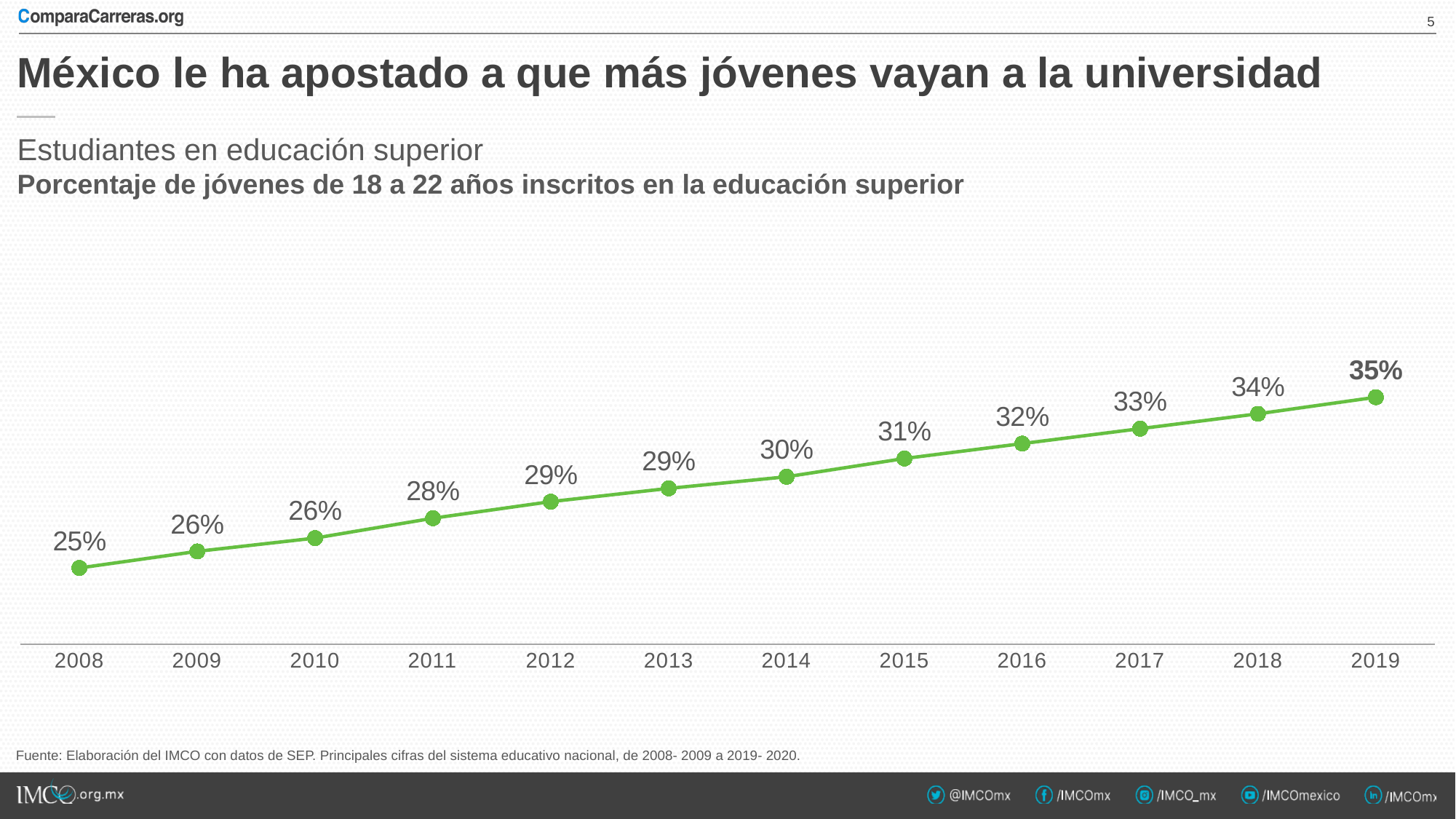
What is the difference between the values for 2019 and 2008? 10% What kind of chart is shown on the slide? Line chart What is the value for 2014? 30% What is the value for 2008? 25% How many years are plotted on the chart? 12 What is the value for 2011? 28% What is the chart's subtitle describing the plotted measure? Porcentaje de jóvenes de 18 a 22 años inscritos en la educación superior Which year has the highest value? 2019 What is the value for 2019? 35% Which year has the lowest value? 2008 Which is larger, the value for 2016 or the value for 2012? 2016 Do the values rise or fall from 2008 to 2019? Rise